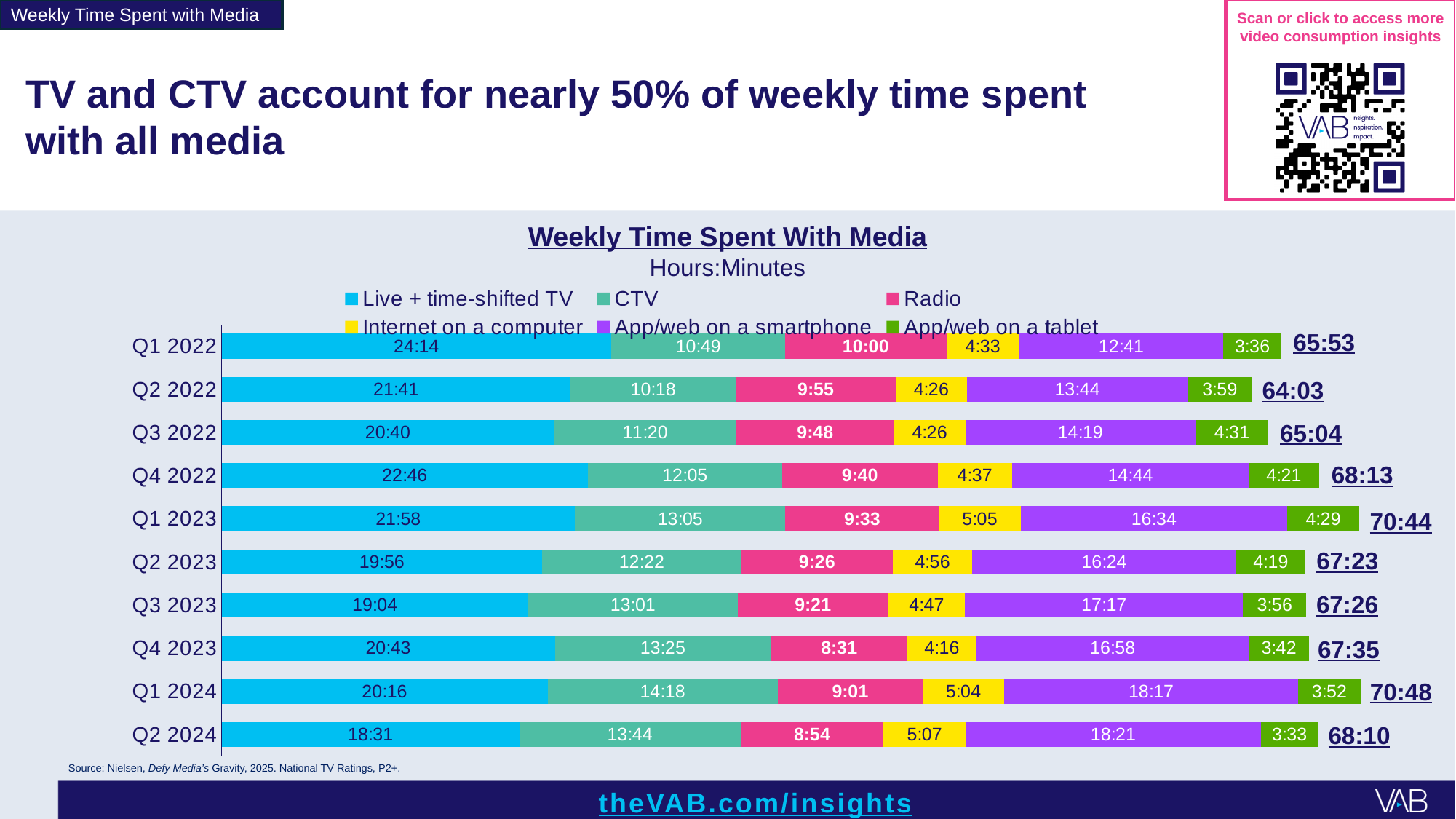
How many series does the legend list? 6 Which quarter has the highest Live + time-shifted TV value? Q1 2022 What is the Radio value for Q4 2023? 8:31 What is the value for Live + time-shifted TV in Q1 2022? 24:14 How many quarters are shown in the chart? 10 What is the difference between the App/web on a smartphone value in Q2 2024 and in Q1 2022? 5:40 What is the total weekly time spent with media for Q1 2023? 70:44 In Q1 2022, which is larger: CTV or Radio? CTV What is the App/web on a smartphone value for Q2 2024? 18:21 Which quarter has the lowest total weekly time spent with media? Q2 2022 What kind of chart is shown on the slide? Stacked bar chart What is the CTV value for Q1 2024? 14:18